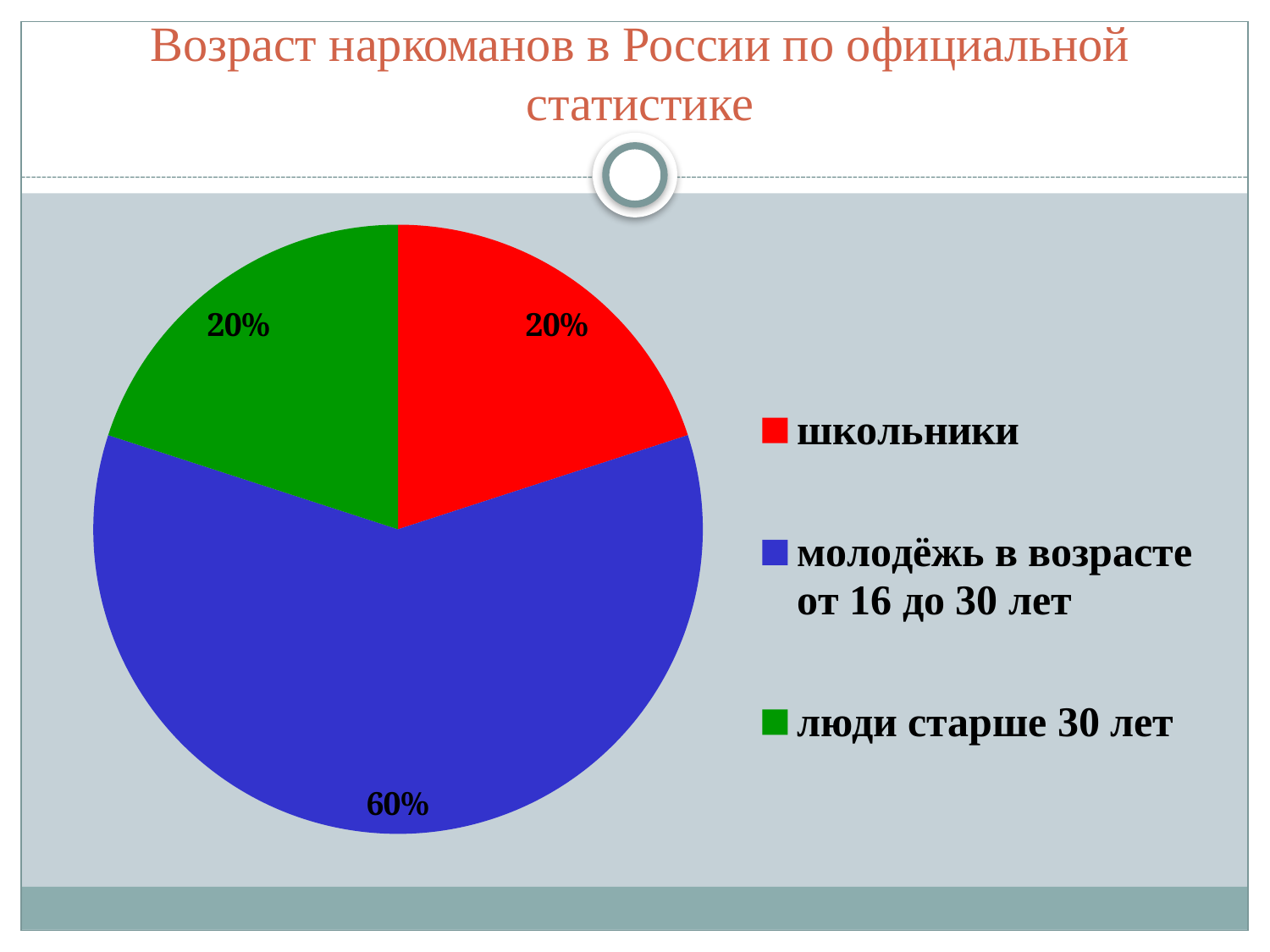
What share of the pie is labelled for молодёжь в возрасте от 16 до 30 лет? 60% What is the combined share of школьники and люди старше 30 лет? 40% What share of the pie is labelled for школьники? 20% What share of the pie is labelled for люди старше 30 лет? 20% What is the title of the chart? Возраст наркоманов в России по официальной статистике What kind of chart is shown on the slide? pie chart What colour is the slice for люди старше 30 лет? green How many categories does the pie chart show? 3 What is the difference between the share for молодёжь в возрасте от 16 до 30 лет and the share for школьники? 40% Which is larger: the share for молодёжь в возрасте от 16 до 30 лет or the share for люди старше 30 лет? молодёжь в возрасте от 16 до 30 лет Which category has the largest slice of the pie? молодёжь в возрасте от 16 до 30 лет